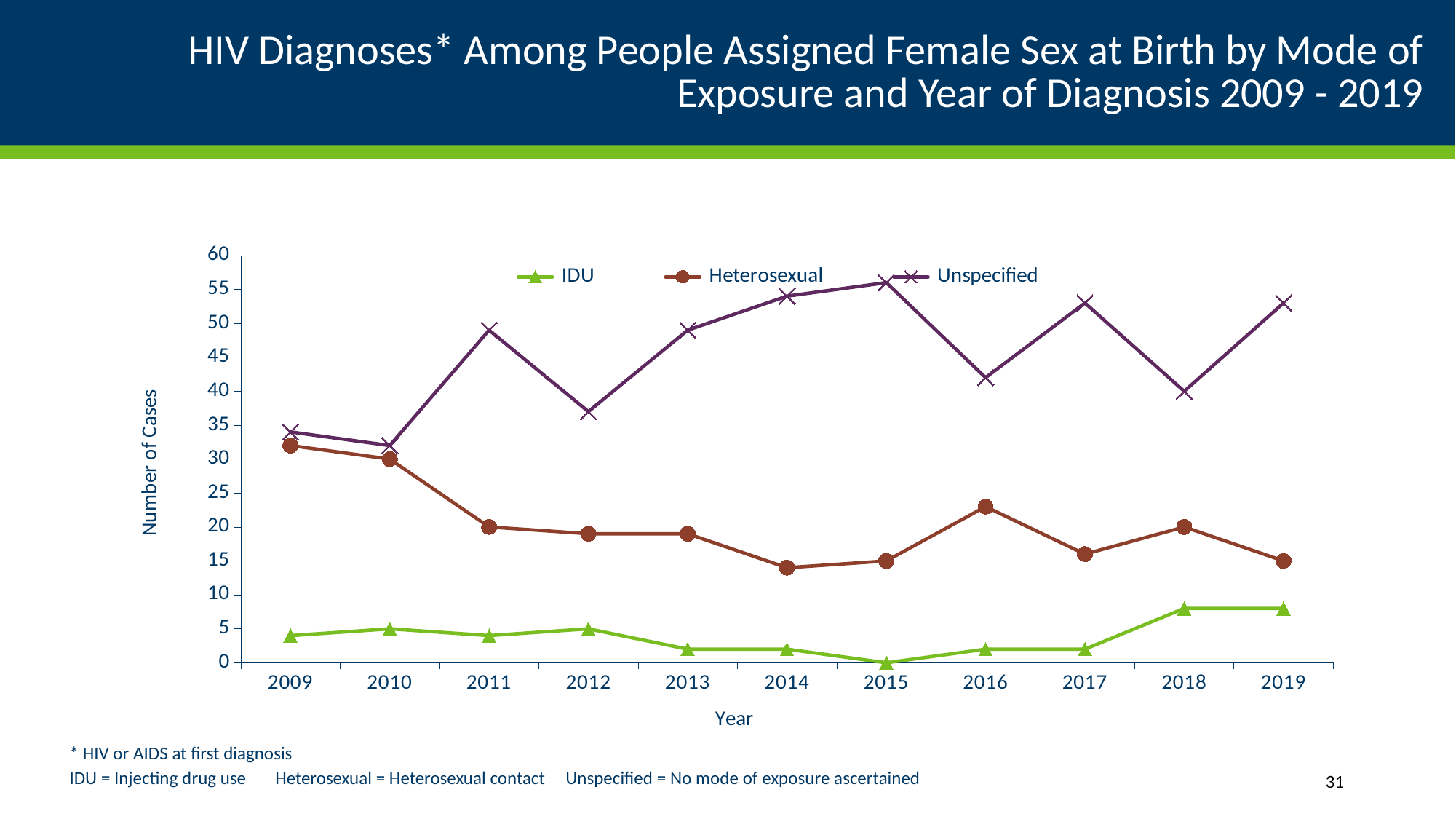
Does the Heterosexual series rise or fall from 2009 to 2014? fall Is the IDU value for 2012 greater or less than 10? less What is the Unspecified value in 2018? 40 In which year is the IDU series at its lowest? 2015 Is the Heterosexual value for 2009 greater or less than 25? greater How many series does the legend list? 3 What kind of chart is shown on the slide? line chart What is the IDU value in 2015? 0 In 2016, which is larger: the Unspecified value or the Heterosexual value? Unspecified What is the Heterosexual value in 2011? 20 How many years are plotted along the x axis? 11 Is the Unspecified value for 2011 greater or less than 45? greater